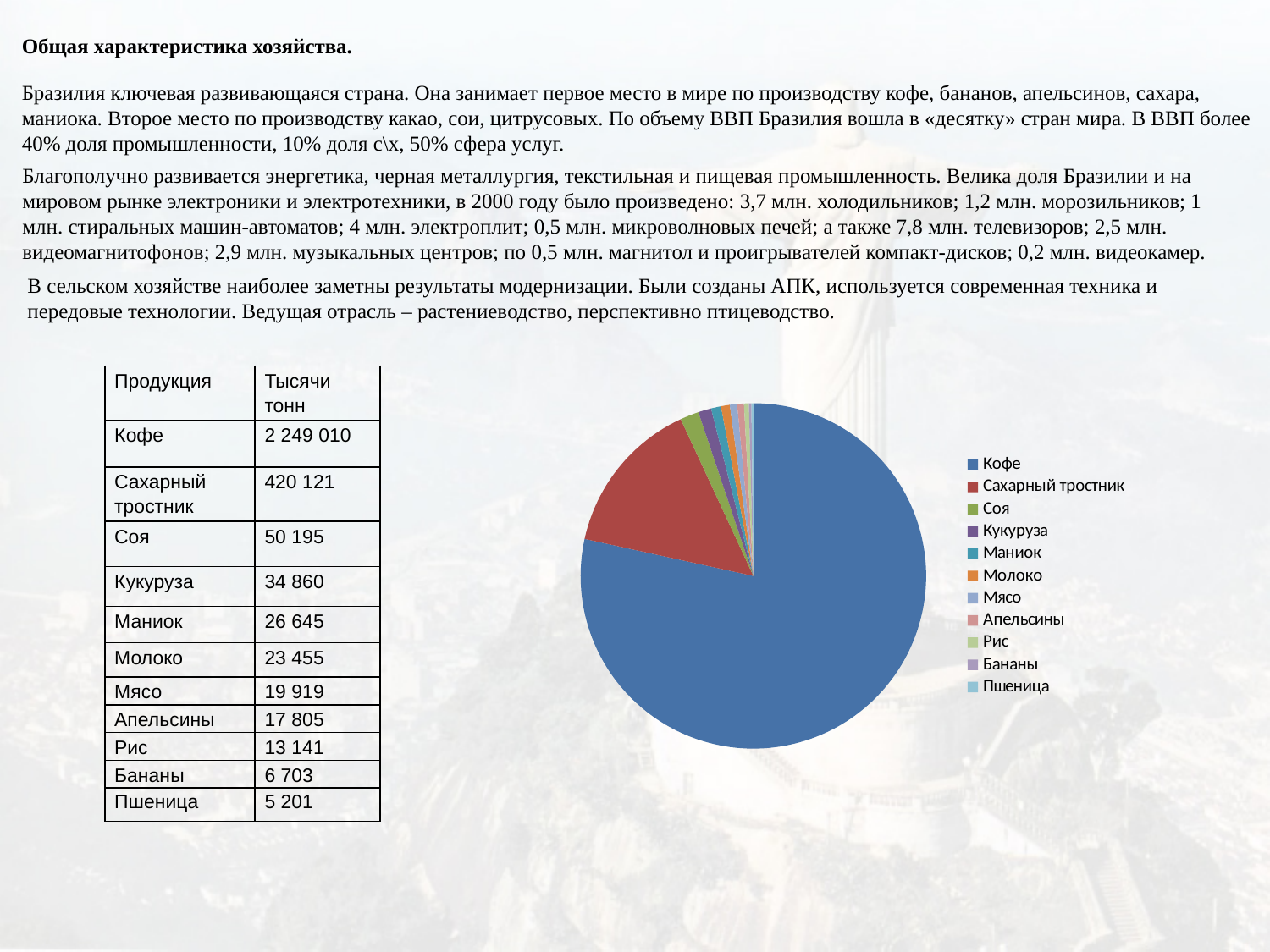
How many categories does the pie chart's legend list? 11 According to the table next to the pie chart, what is the value for Кофе (thousand tonnes)? 2 249 010 According to the table next to the pie chart, what is the value for Сахарный тростник (thousand tonnes)? 420 121 What kind of chart is shown on the slide? pie chart Which category is listed second in the pie chart's legend? Сахарный тростник What colour is the Кофе slice in the pie chart? blue Which slice is larger in the pie chart, Кофе or Сахарный тростник? Кофе Using the values in the table, what is the difference between Кофе and Сахарный тростник (thousand tonnes)? 1 828 889 According to the table next to the pie chart, what is the value for Соя (thousand tonnes)? 50 195 Which category has the smallest slice in the pie chart? Пшеница Which category has the largest slice in the pie chart? Кофе According to the table next to the pie chart, what is the value for Пшеница (thousand tonnes)? 5 201